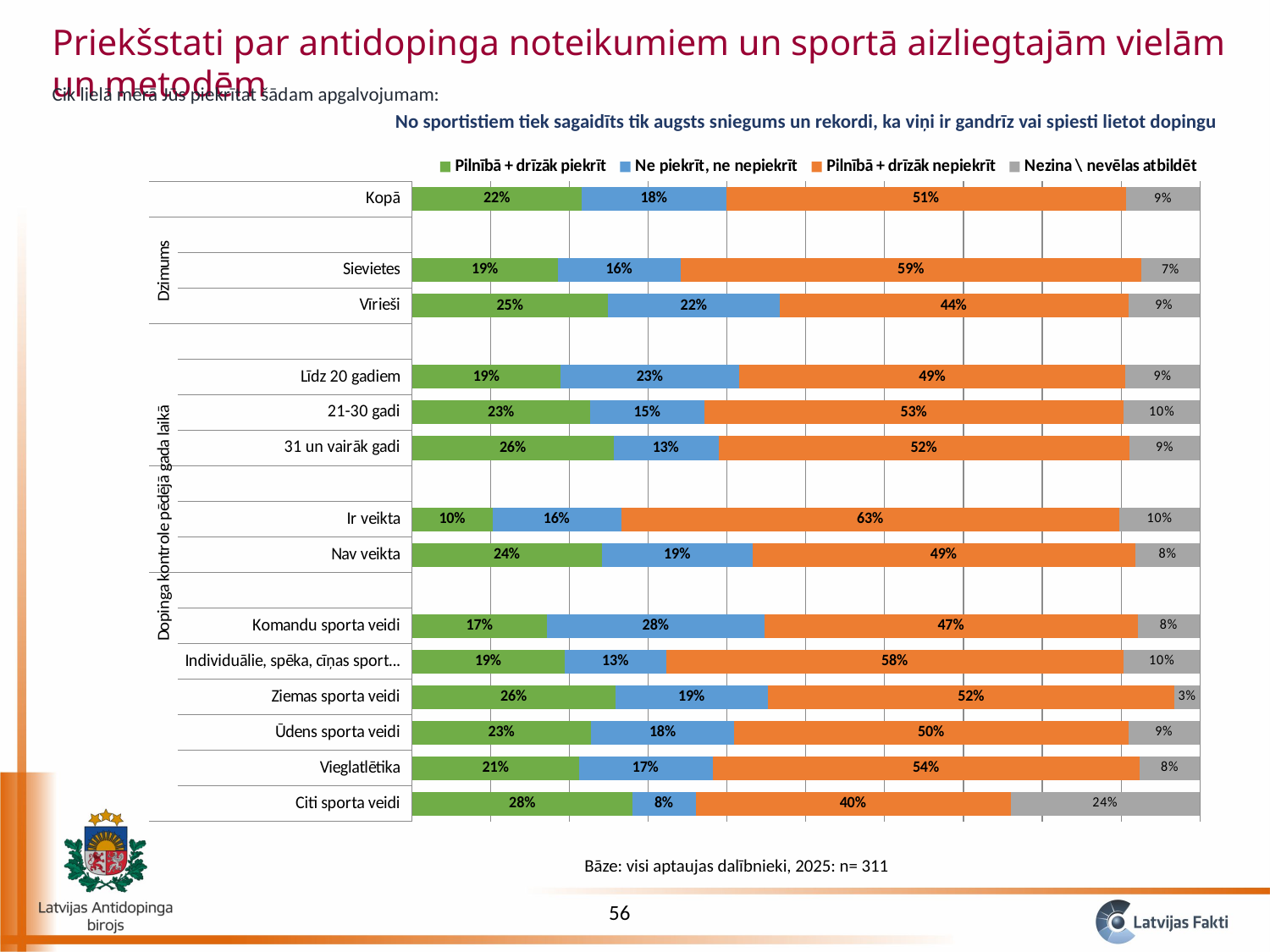
Which category has the highest value for "Pilnībā + drīzāk nepiekrīt"? Ir veikta How many categories are plotted in the chart? 14 Which is larger: the "Pilnībā + drīzāk piekrīt" value for Vīrieši or for Sievietes? Vīrieši Which category has the lowest value for "Pilnībā + drīzāk piekrīt"? Ir veikta What is the difference between the "Pilnībā + drīzāk nepiekrīt" values for Sievietes and Vīrieši? 15% What is the value of "Nezina \ nevēlas atbildēt" for Citi sporta veidi? 24% What is the value of "Pilnībā + drīzāk piekrīt" for Ir veikta? 10% What is the total of the stacked bar for Ziemas sporta veidi? 100% How many series does the legend list? 4 What is the value of "Ne piekrīt, ne nepiekrīt" for Komandu sporta veidi? 28% What is the value of "Pilnībā + drīzāk nepiekrīt" for Kopā? 51% What kind of chart is shown on the slide? Stacked bar chart